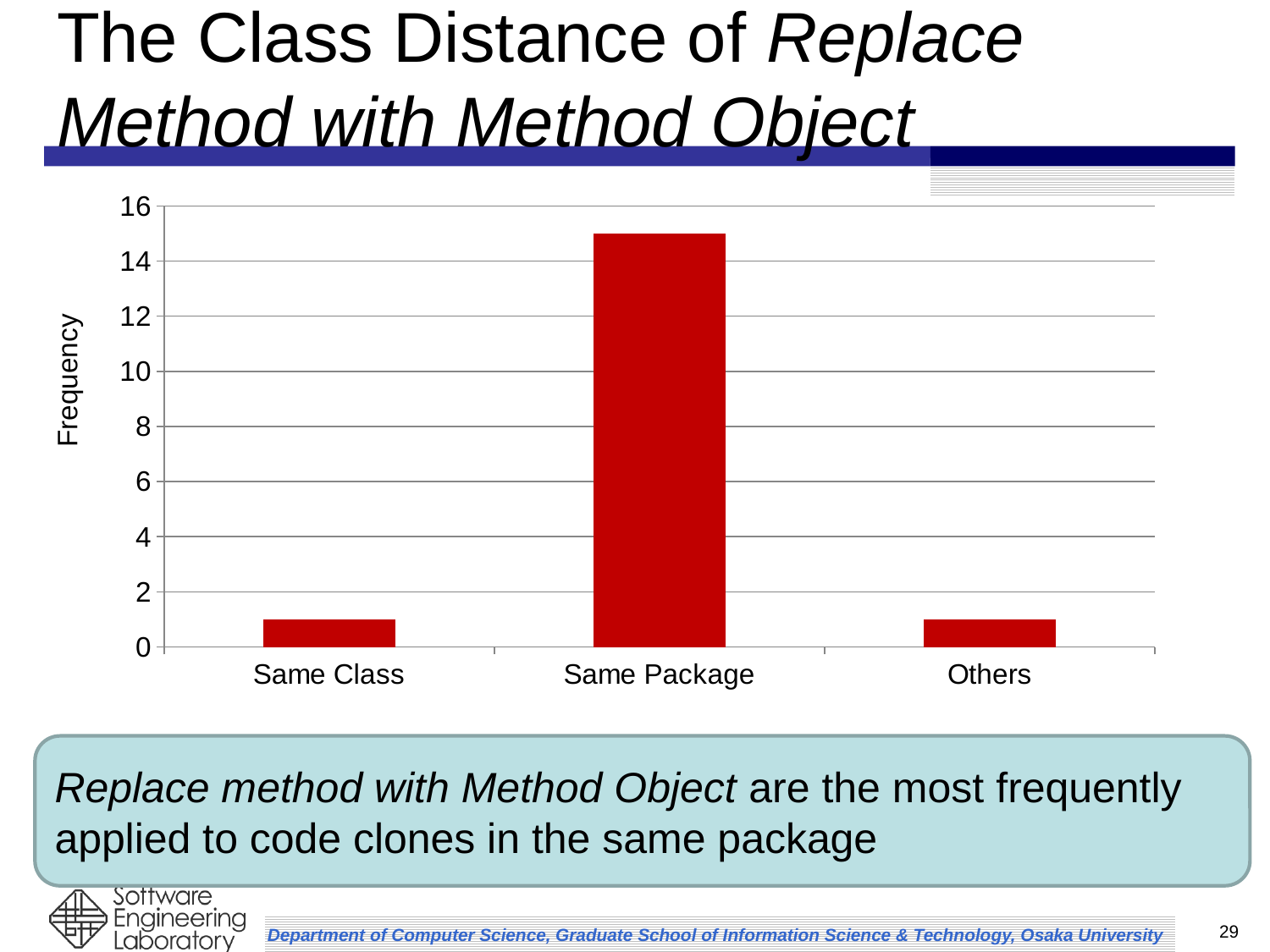
Which has a higher frequency, Same Class or Same Package? Same Package How many categories are shown on the x axis of the chart? 3 Is the frequency for Others greater or less than 4? less What kind of chart is shown on the slide? bar chart Is the frequency for Same Class greater or less than 2? less Which has a higher frequency, Same Package or Others? Same Package What is the label on the y axis of the chart? Frequency Is the frequency for Same Package greater or less than 10? greater Which category has the highest frequency? Same Package What is the maximum value shown on the y axis of the chart? 16